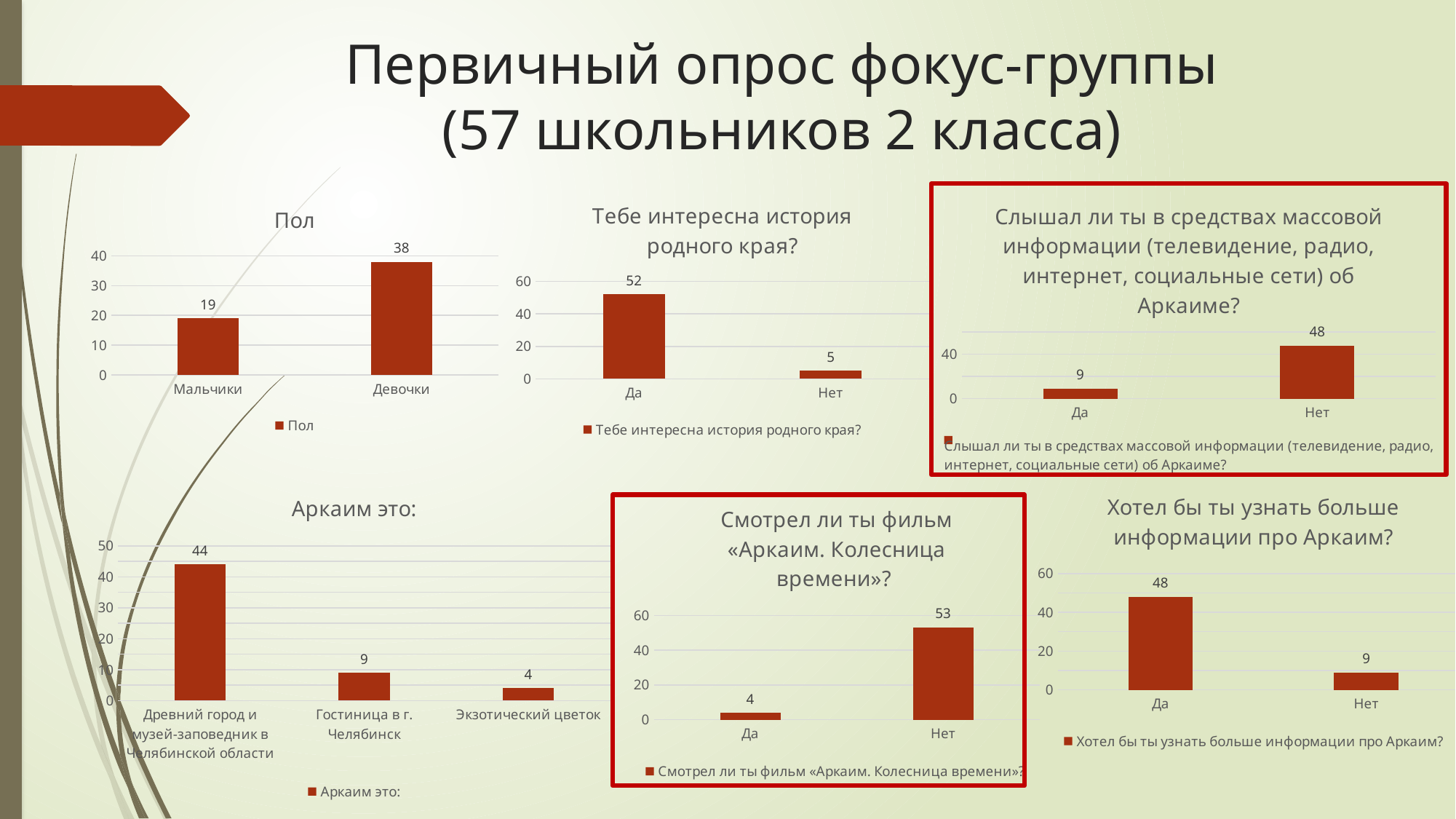
In the chart titled "Слышал ли ты в средствах массовой информации (телевидение, радио, интернет, социальные сети) об Аркаиме?", which is larger, Да or Нет? Нет In the chart titled "Пол", what is the difference between the values for Девочки and Мальчики? 19 In the chart titled "Смотрел ли ты фильм «Аркаим. Колесница времени»?", what is the difference between the values for Нет and Да? 49 In the chart titled "Тебе интересна история родного края?", which category has the lowest value? Нет In the chart titled "Пол", what is the value for Девочки? 38 In the chart titled "Аркаим это:", which category has the highest value? Древний город и музей-заповедник в Челябинской области What kind of chart is the one titled "Хотел бы ты узнать больше информации про Аркаим?"? bar chart In the chart titled "Пол", what is the value for Мальчики? 19 In the chart titled "Тебе интересна история родного края?", what is the value for Да? 52 In the chart titled "Слышал ли ты в средствах массовой информации (телевидение, радио, интернет, социальные сети) об Аркаиме?", what is the value for Нет? 48 In the chart titled "Аркаим это:", how many categories are shown? 3 In the chart titled "Аркаим это:", what is the value for Экзотический цветок? 4